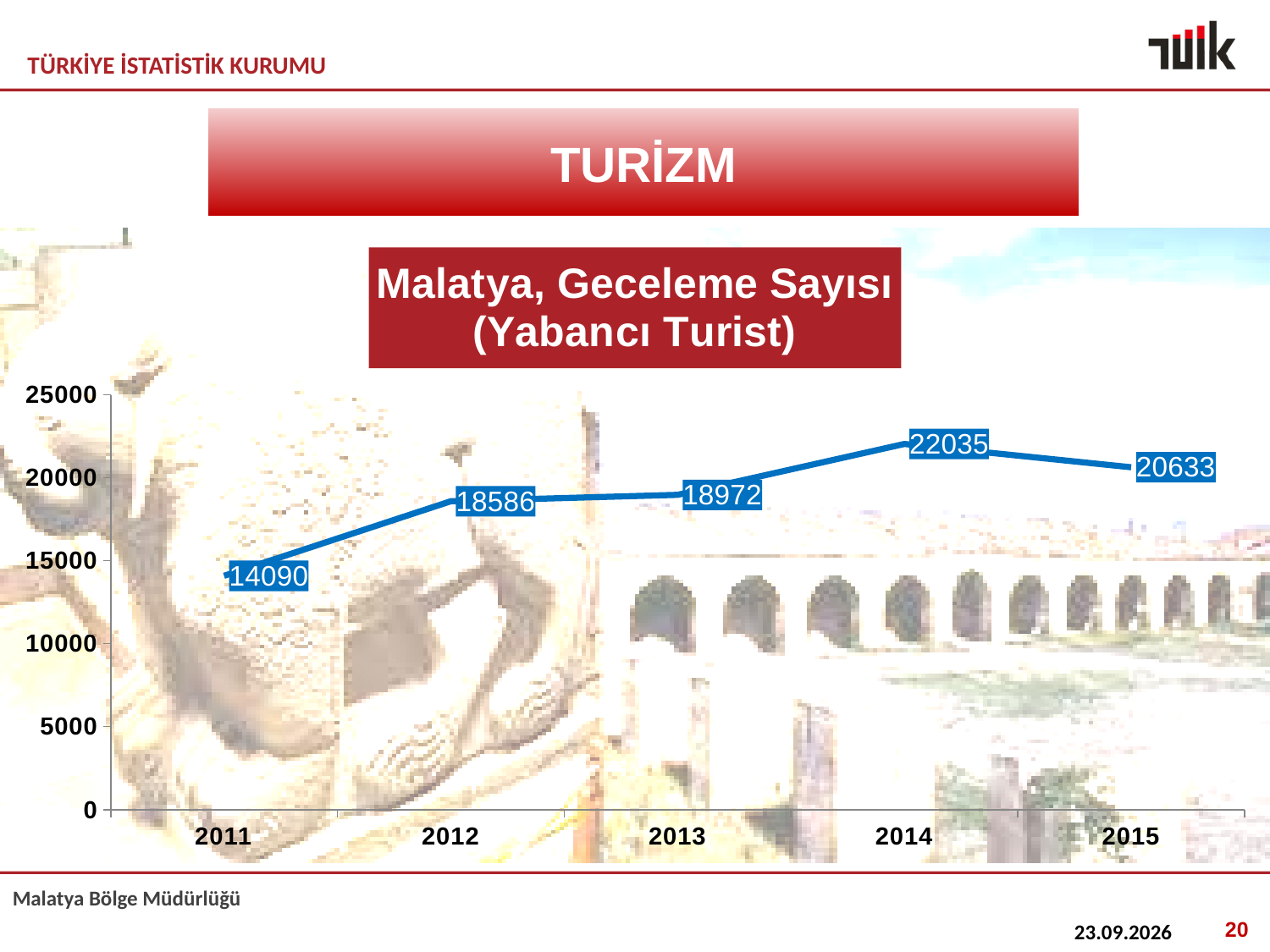
What is the number of overnight stays in 2011? 14090 What kind of chart is shown on the slide? line chart How many years are plotted on the chart? 5 Which year has the lowest number of overnight stays? 2011 What is the value shown for 2015? 20633 What is the title of the chart? Malatya, Geceleme Sayısı (Yabancı Turist) What is the difference between the 2012 and 2011 values? 4496 Which year has the highest number of overnight stays? 2014 Which year has a larger value, 2013 or 2012? 2013 Is the value for 2013 greater or less than 20000? less What is the number of overnight stays in 2014? 22035 What is the difference between the 2014 and 2015 values? 1402